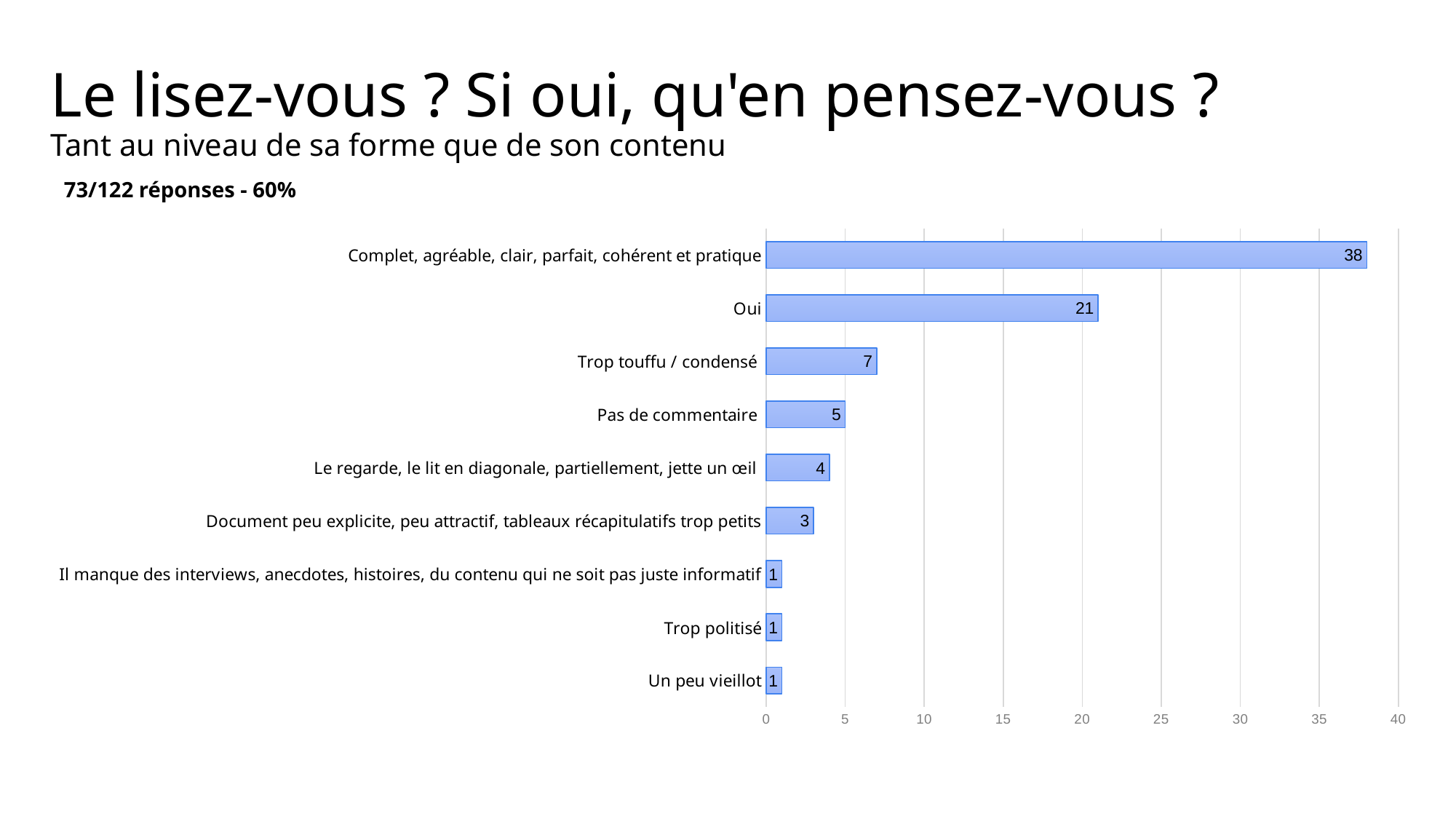
What is the value for "Le regarde, le lit en diagonale, partiellement, jette un œil"? 4 What is the value for "Oui"? 21 Which is larger, the value for "Trop touffu / condensé" or the value for "Pas de commentaire"? Trop touffu / condensé What is the value for "Pas de commentaire"? 5 Is the value for "Oui" greater or less than 20? greater What is the value for "Trop touffu / condensé"? 7 Which category has the highest value? Complet, agréable, clair, parfait, cohérent et pratique What is the difference between the values for "Complet, agréable, clair, parfait, cohérent et pratique" and "Oui"? 17 How many categories are shown in the chart? 9 What is the difference between the values for "Trop touffu / condensé" and "Trop politisé"? 6 What kind of chart is shown on the slide? Bar chart What is the value for "Document peu explicite, peu attractif, tableaux récapitulatifs trop petits"? 3